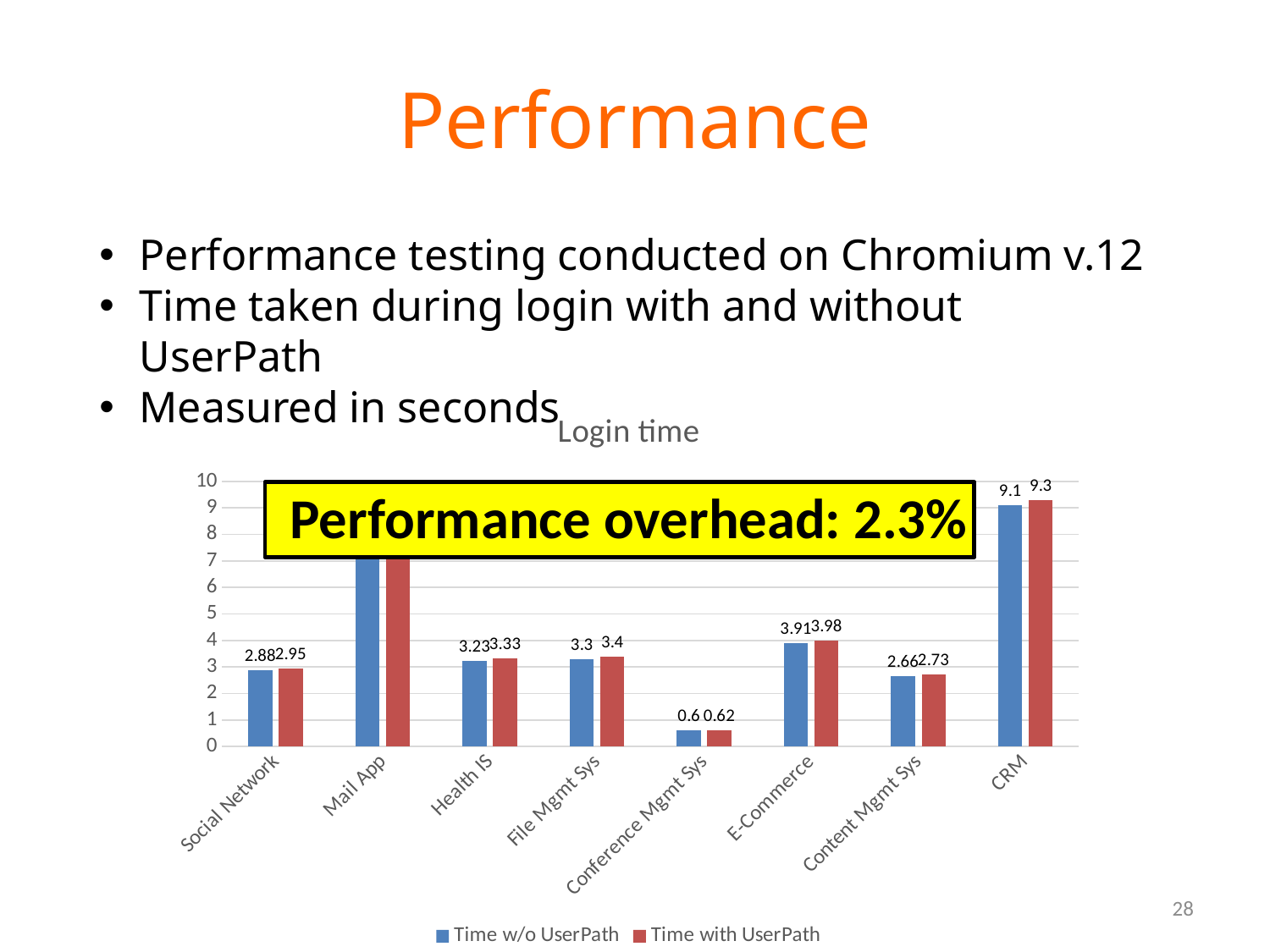
How many categories are shown on the x axis of the chart? 8 Which is larger: Time w/o UserPath for E-Commerce or for Content Mgmt Sys? E-Commerce What is the title of the chart? Login time What is the value of Time with UserPath for CRM? 9.3 What is the difference between Time with UserPath and Time w/o UserPath for CRM? 0.2 Which category has the lowest Time w/o UserPath? Conference Mgmt Sys What is the value of Time w/o UserPath for E-Commerce? 3.91 How many series does the chart legend list? 2 What kind of chart is shown on the slide? bar chart Is the value of Time w/o UserPath for Mail App greater or less than 5? greater Which category has the highest Time with UserPath? CRM What is the value of Time w/o UserPath for Conference Mgmt Sys? 0.6